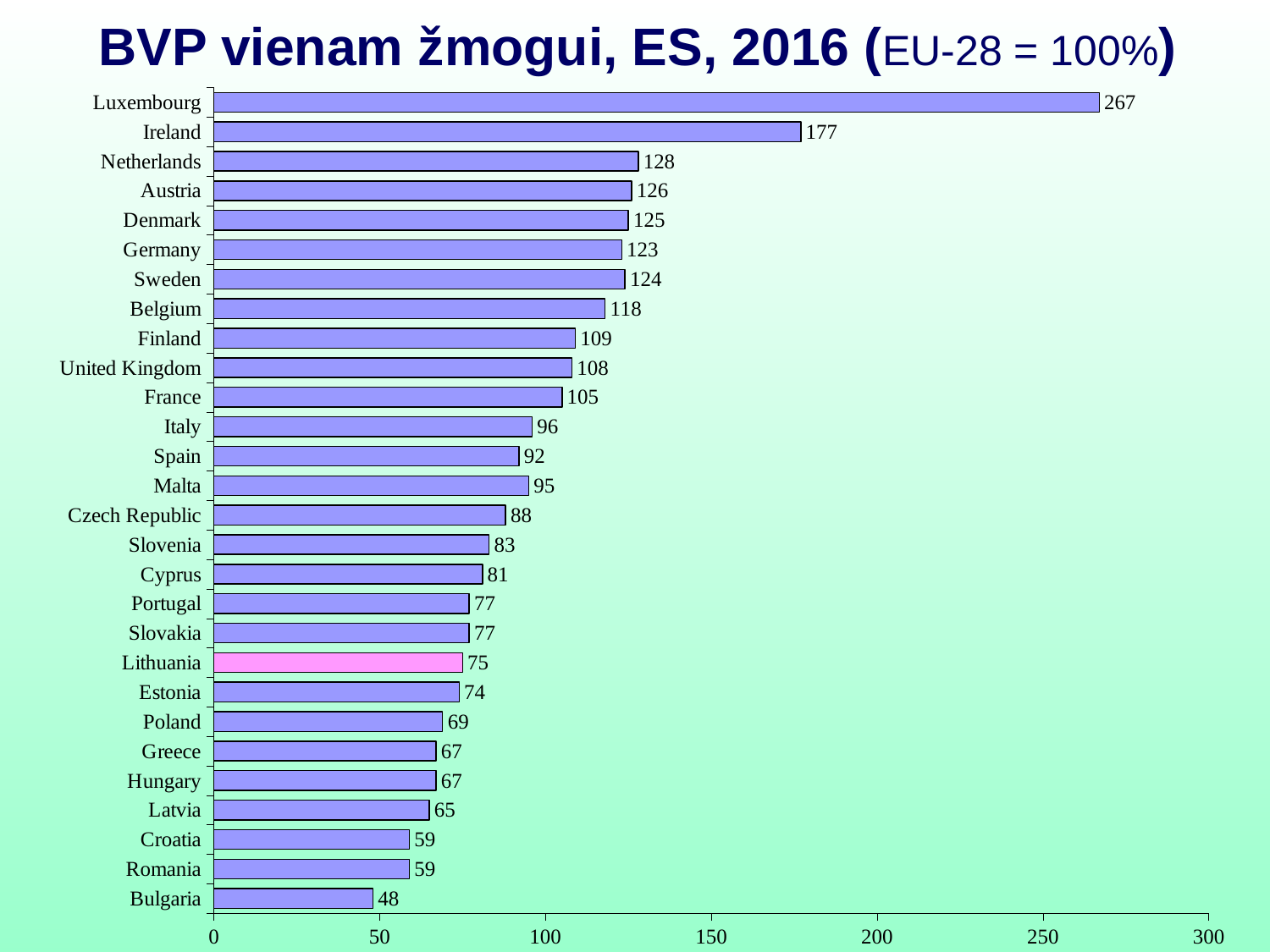
Which country has the highest value? Luxembourg Which country's bar is highlighted in a different colour (pink) from the others? Lithuania How many countries are shown in the chart? 28 What is the value for Ireland? 177 What is the value for Lithuania? 75 What kind of chart is shown on the slide? bar chart What is the difference between the values for Luxembourg and Ireland? 90 What is the difference between the values for Lithuania and Estonia? 1 Is the value for Finland greater or less than 100? greater Which is larger, the value for Netherlands or the value for Belgium? Netherlands Which country has the lowest value? Bulgaria What is the value for Czech Republic? 88